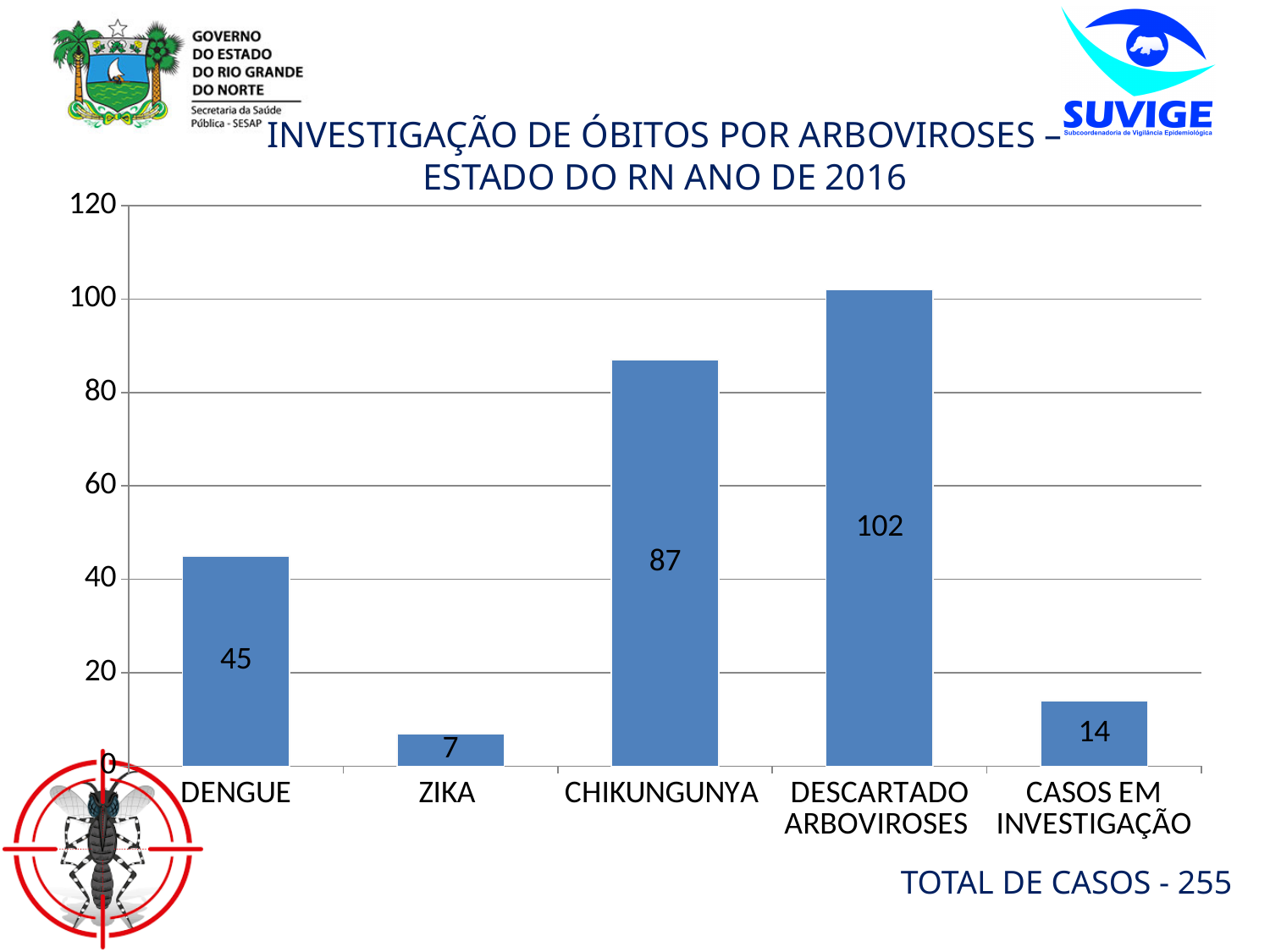
What is the difference between the values for DESCARTADO ARBOVIROSES and CHIKUNGUNYA? 15 How many categories are shown on the x axis? 5 What is the value for ZIKA? 7 What is the value for CHIKUNGUNYA? 87 What kind of chart is shown on the slide? bar chart What total number of cases is stated below the chart? 255 Which category has the highest value? DESCARTADO ARBOVIROSES Is the value for CHIKUNGUNYA greater or less than 80? greater What is the value for DENGUE? 45 Which category has the lowest value? ZIKA What is the value for CASOS EM INVESTIGAÇÃO? 14 Which is larger, the value for DENGUE or the value for CASOS EM INVESTIGAÇÃO? DENGUE